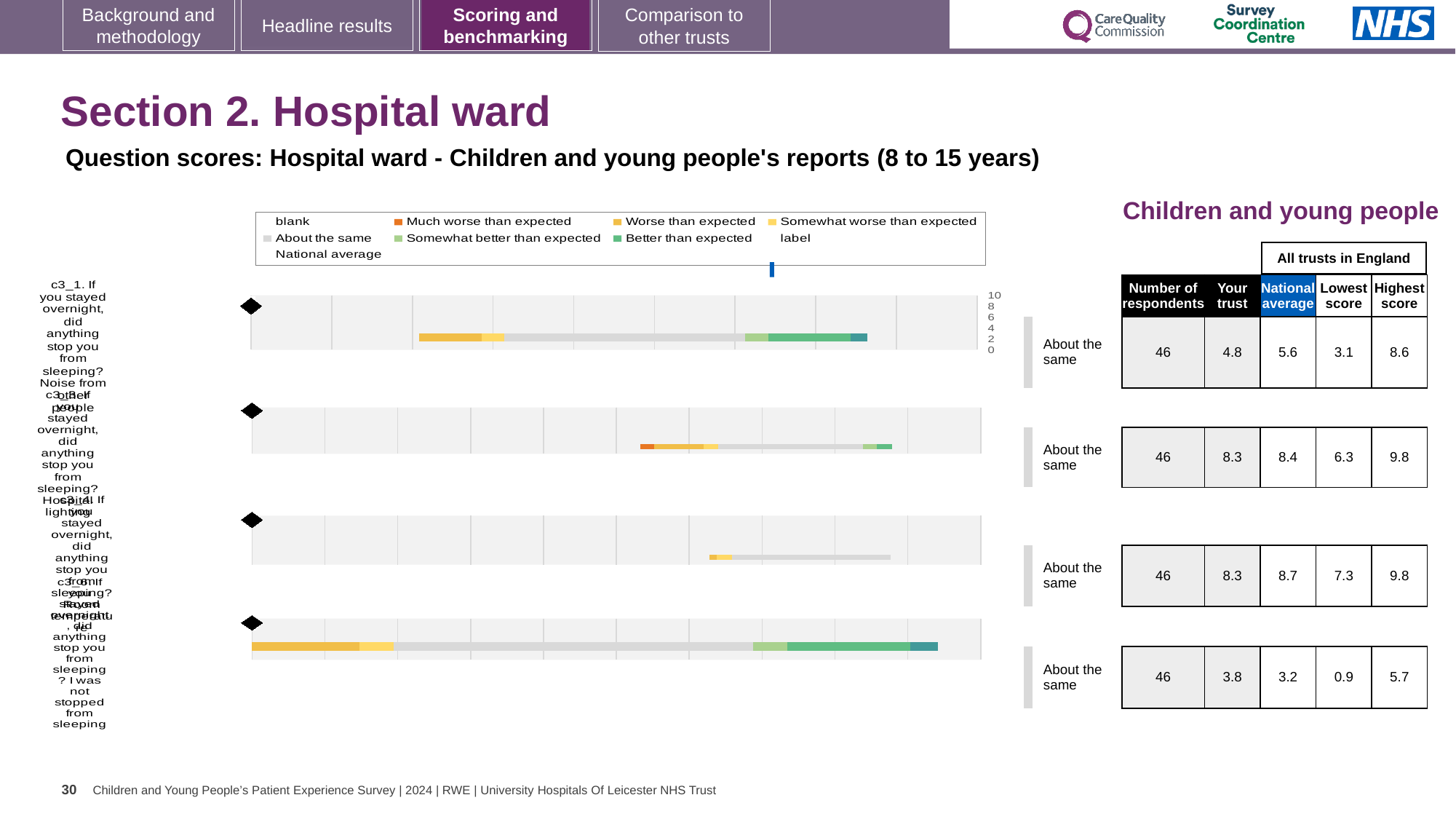
In the table beside the chart, what is the difference between the highest score and the lowest score for the second row? 3.5 What is the subtitle above the chart? Question scores: Hospital ward - Children and young people's reports (8 to 15 years) In the table beside the chart, what is the highest score for the third row? 9.8 What benchmark label is shown next to each of the four bars? About the same For the fourth (bottom) row, which is larger: the 'Your trust' score or the national average? Your trust In the table beside the chart, what is the national average for the fourth (bottom) row? 3.2 What kind of chart is shown on the slide? bar chart How many question bars are plotted in the chart? 4 Which row has the lowest 'Your trust' score in the table beside the chart? the fourth (bottom) row In the table beside the chart, how many respondents are listed for the second row? 46 How many entries does the chart legend list? 9 In the table beside the chart, what is the 'Your trust' score for the first row (c3_1, noise from other people)? 4.8